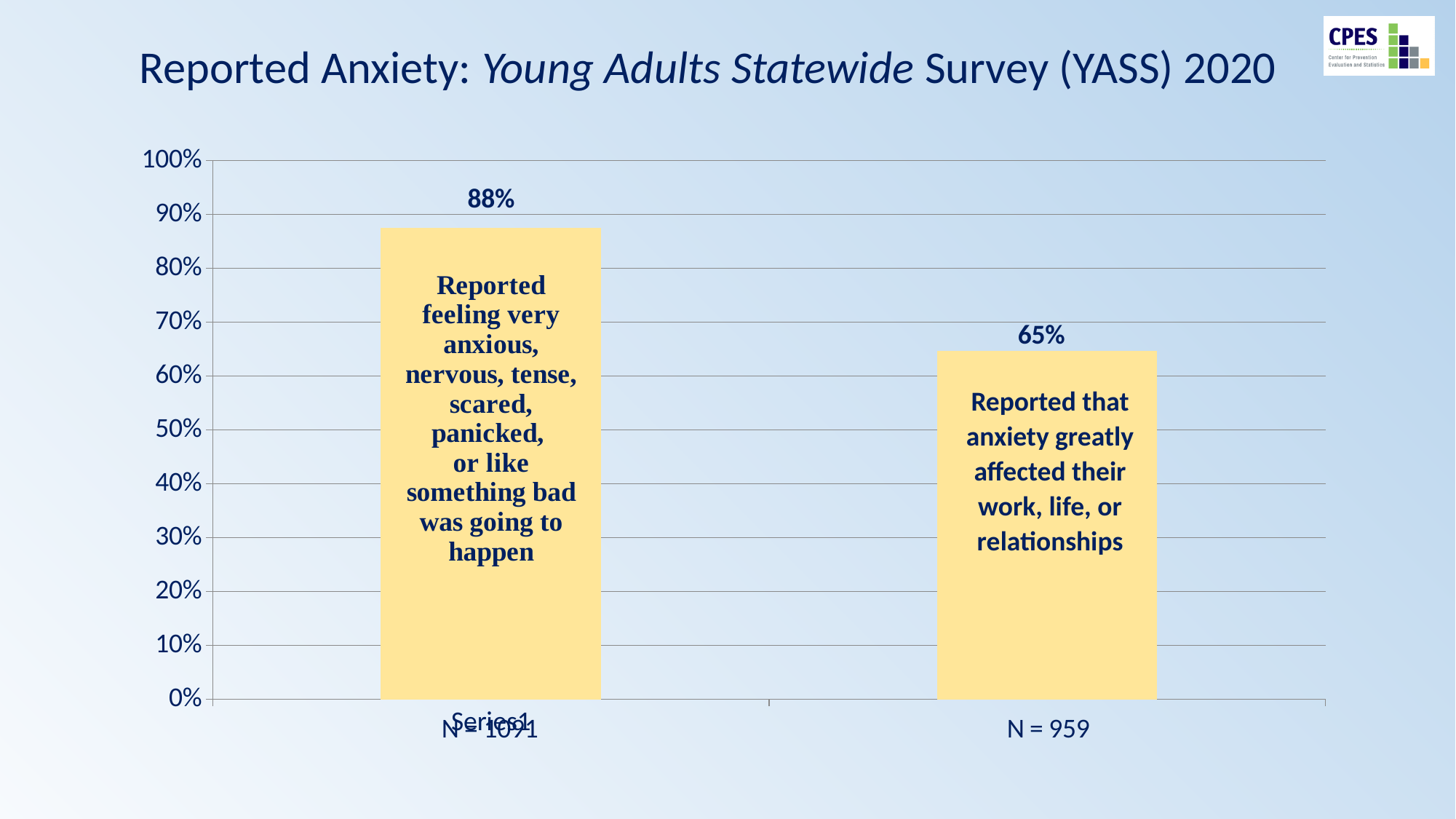
What is the sample size (N) shown under the bar for anxiety greatly affecting work, life, or relationships? N = 959 What is the title of the slide? Reported Anxiety: Young Adults Statewide Survey (YASS) 2020 What percentage of respondents reported that anxiety greatly affected their work, life, or relationships? 65% What is the maximum value shown on the vertical axis? 100% What percentage of respondents reported feeling very anxious, nervous, tense, scared, panicked, or like something bad was going to happen? 88% Which bar shows the lower value? Reported that anxiety greatly affected their work, life, or relationships Is the value for anxiety greatly affecting work, life, or relationships greater or less than 70%? less What is the difference in percentage points between the two bars? 23 percentage points How many bars are plotted on the chart? 2 What kind of chart is shown on the slide? Bar chart Is the value for reported feeling very anxious greater or less than 80%? greater Which bar shows the higher value: reported feeling very anxious or reported that anxiety greatly affected their work, life, or relationships? Reported feeling very anxious